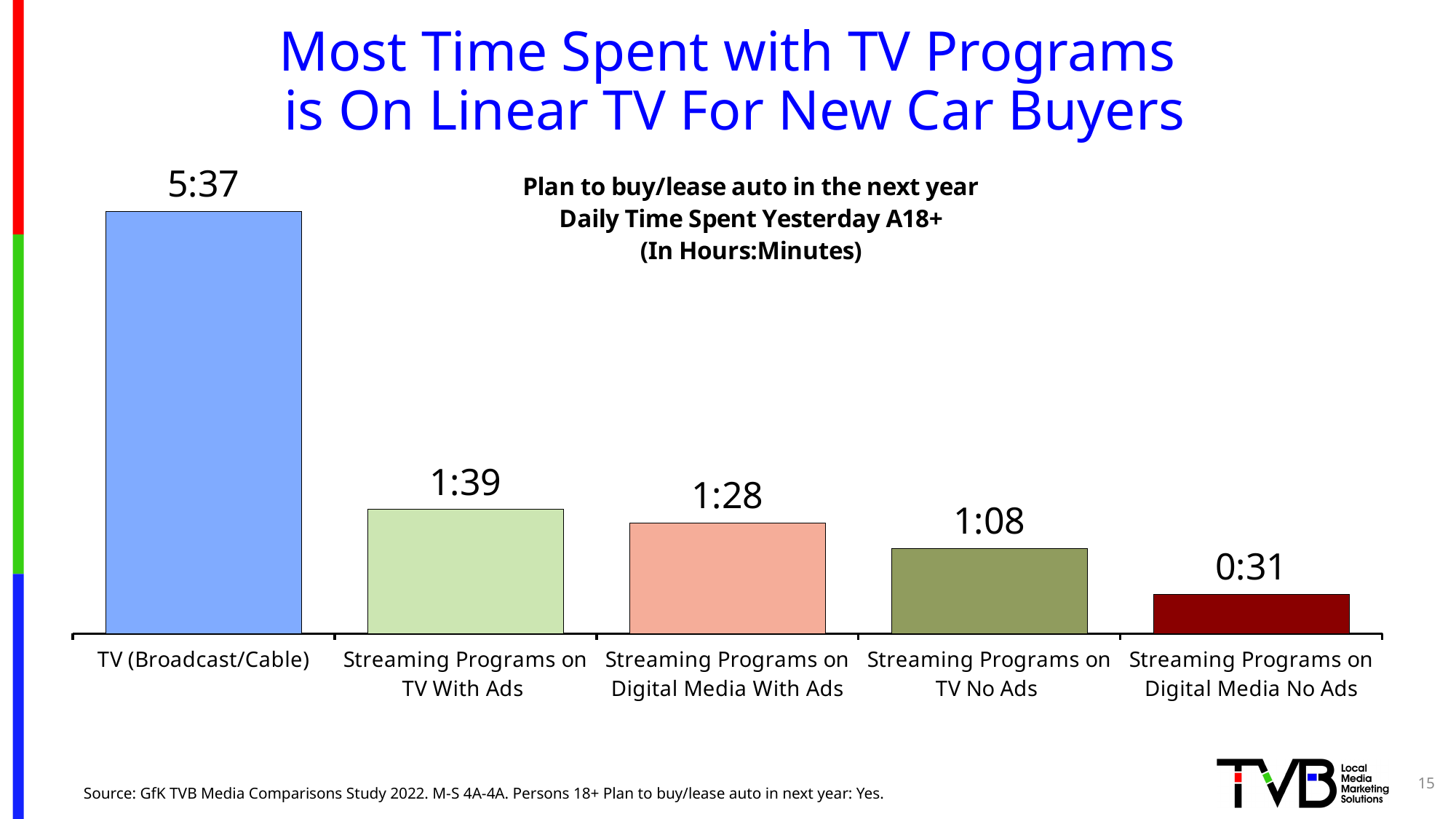
In what units are the values in the chart expressed? Hours:Minutes Which is larger: daily time spent on Streaming Programs on TV With Ads or on Streaming Programs on TV No Ads? Streaming Programs on TV With Ads What is the daily time spent on Streaming Programs on TV No Ads? 1:08 Which category has the lowest daily time spent? Streaming Programs on Digital Media No Ads What is the daily time spent on Streaming Programs on TV With Ads? 1:39 Which category has the highest daily time spent? TV (Broadcast/Cable) How many categories are shown in the chart? 5 What kind of chart is shown on the slide? Bar chart What is the daily time spent on TV (Broadcast/Cable)? 5:37 What is the daily time spent on Streaming Programs on Digital Media No Ads? 0:31 How much more daily time is spent on Streaming Programs on TV No Ads than on Streaming Programs on Digital Media No Ads? 0:37 What is the daily time spent on Streaming Programs on Digital Media With Ads? 1:28